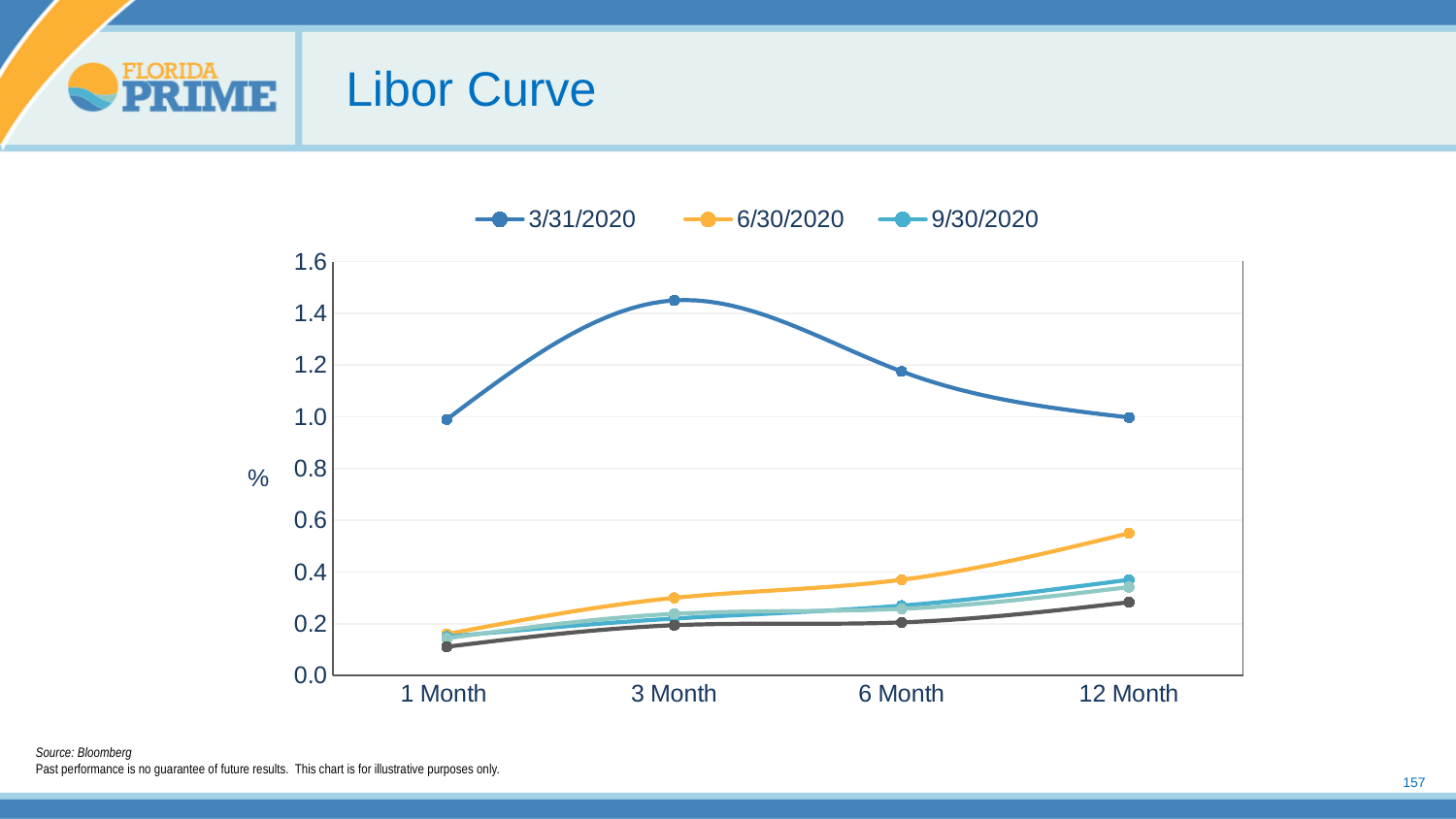
How many series does the legend list? 3 Is the 9/30/2020 value at 1 Month greater or less than 0.2? less For the 6/30/2020 series, at which maturity is the value lowest? 1 Month For the 6/30/2020 series, at which maturity is the value highest? 12 Month Is the 6/30/2020 value at 12 Month greater or less than 0.4? greater At 3 Month, which series has the larger value, 3/31/2020 or 6/30/2020? 3/31/2020 What kind of chart is shown on the slide? Line chart How many categories are shown on the x axis? 4 Is the 3/31/2020 value at 3 Month greater or less than 1.2? greater What is the label on the y axis? % Do the values for the 6/30/2020 series rise or fall from 1 Month to 12 Month? Rise For the 3/31/2020 series, at which maturity is the value highest? 3 Month